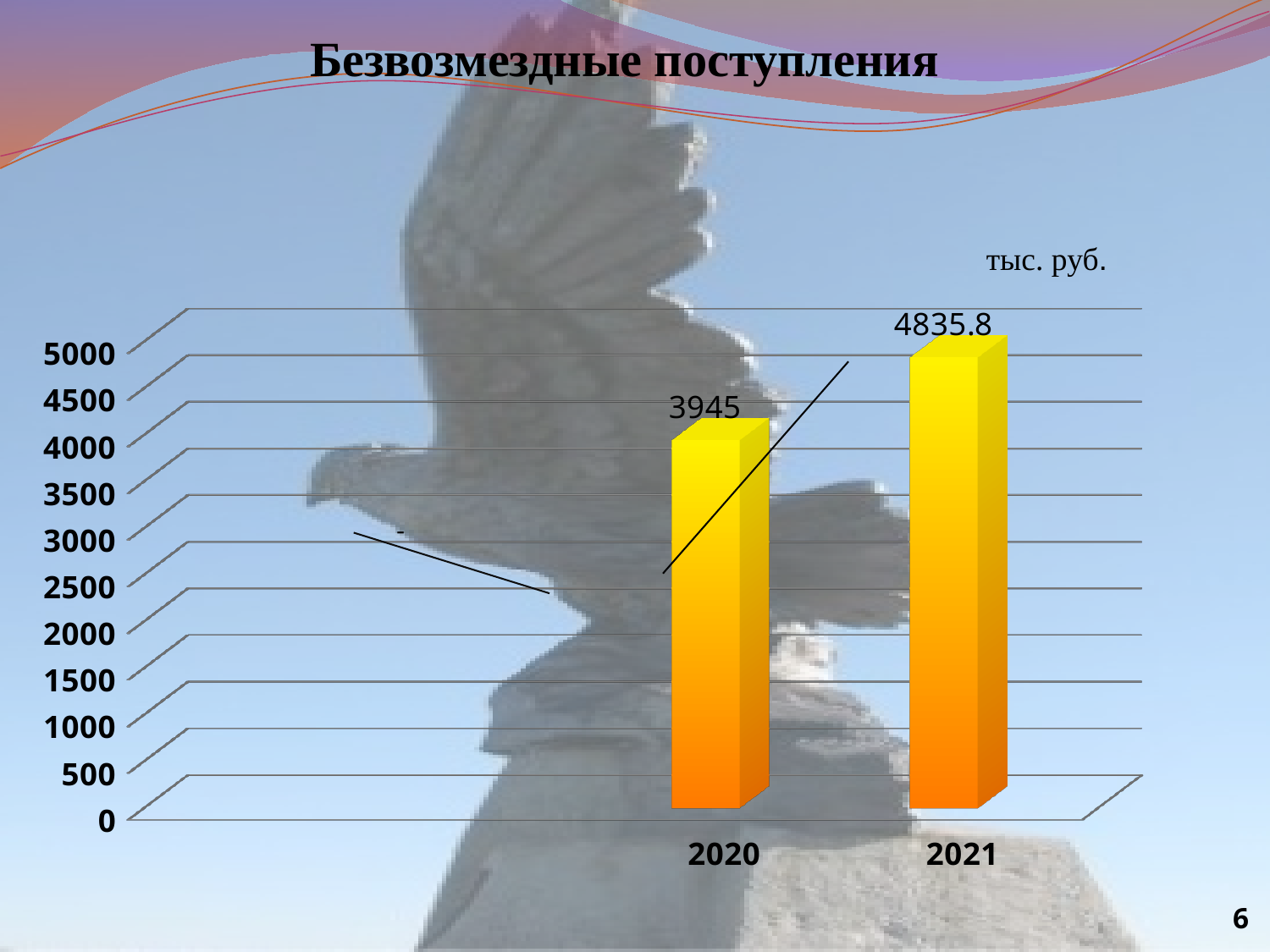
Is the value for 2021 greater or less than 5000? less What is the difference between the values for 2021 and 2020? 890.8 Is the value for 2020 greater or less than 3500? greater Which year has the highest value? 2021 What is the value for 2020? 3945 What is the title of the chart? Безвозмездные поступления How many categories are shown on the x axis? 2 Do the values rise or fall from 2020 to 2021? rise Which is larger, the value for 2020 or the value for 2021? 2021 What is the value for 2021? 4835.8 Which year has the lowest value? 2020 What kind of chart is shown on the slide? bar chart